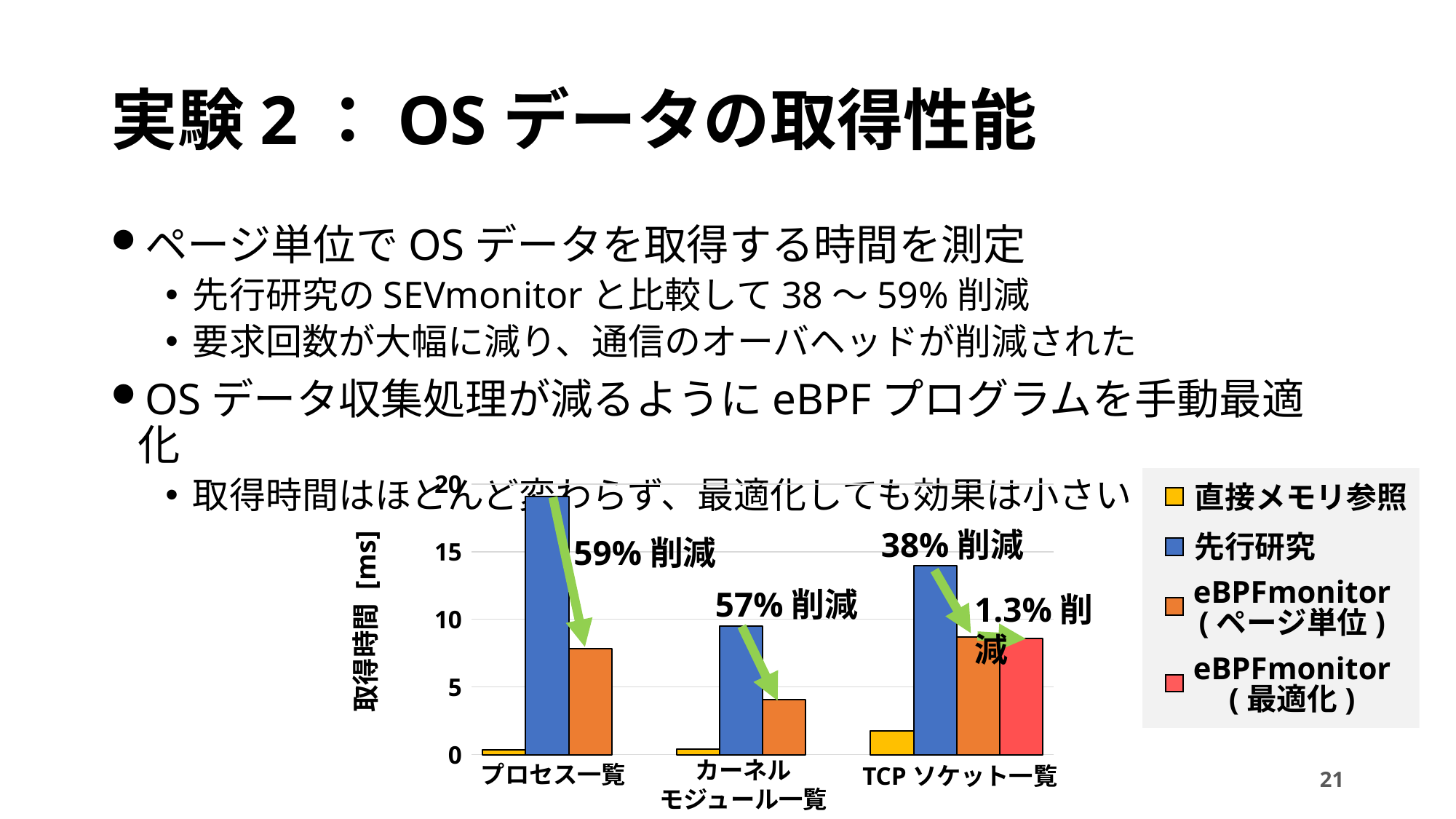
Which category has the lowest value for the 先行研究 series? カーネルモジュール一覧 For カーネルモジュール一覧, which is larger: the 先行研究 value or the eBPFmonitor (ページ単位) value? 先行研究 What is the label of the y axis of the chart? 取得時間 [ms] Is the eBPFmonitor (ページ単位) value for プロセス一覧 greater or less than 10? less Is the 先行研究 value for プロセス一覧 greater or less than 15? greater How many series does the chart legend list? 4 What reduction percentage is annotated above the プロセス一覧 bars? 59% 削減 Is the 先行研究 value for TCP ソケット一覧 greater or less than 10? greater What kind of chart is shown on the slide? bar chart How many categories are shown on the x axis of the chart? 3 Which category has the highest value for the 先行研究 series? プロセス一覧